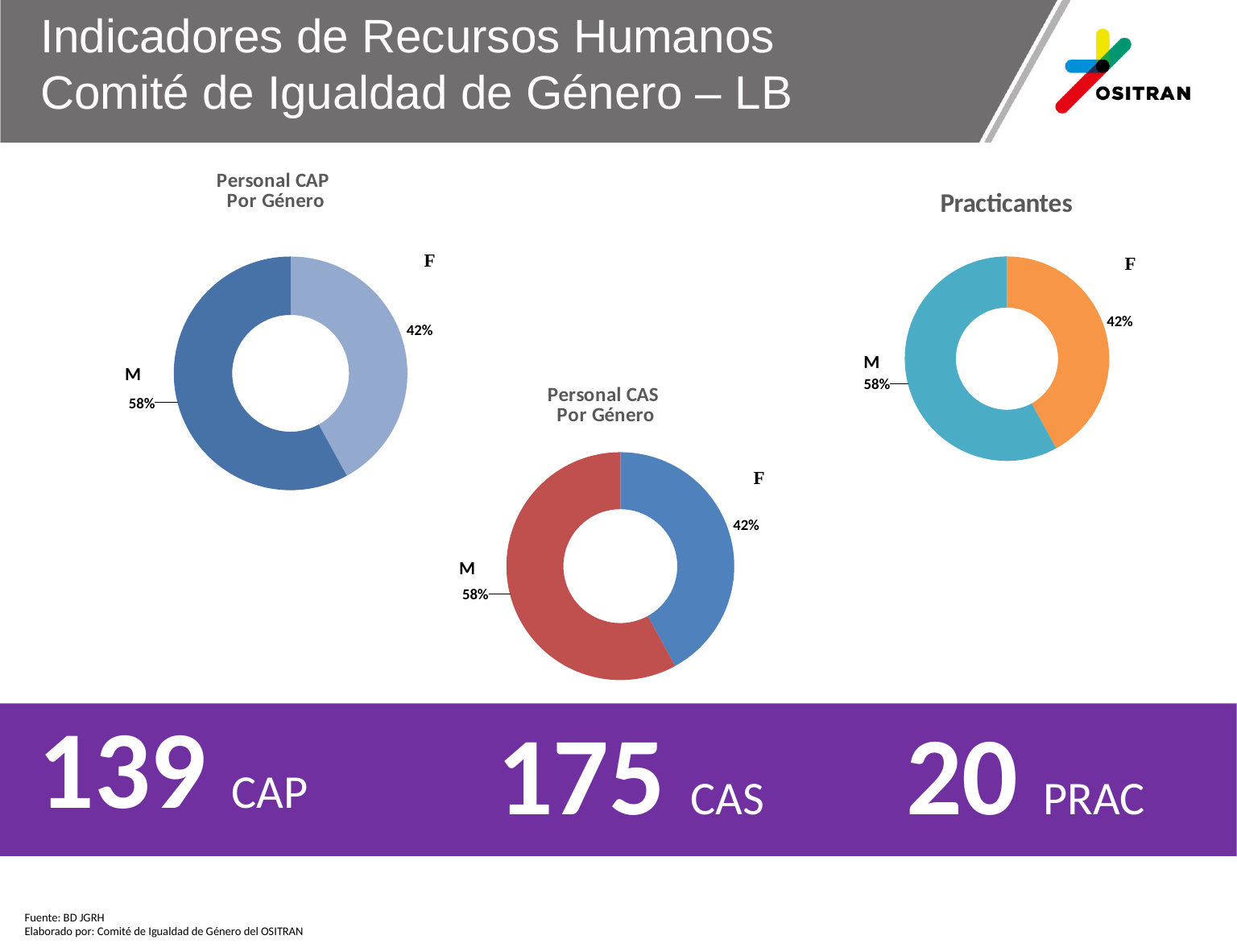
In the 'Personal CAS Por Género' chart, which category has the smallest share? F In the 'Personal CAS Por Género' chart, what share is labelled for F? 42% In the 'Personal CAP Por Género' chart, which category has the largest share? M What kind of chart is the 'Practicantes' chart? Doughnut chart How many doughnut charts are shown on the slide? 3 In the 'Personal CAP Por Género' chart, what is the difference in percentage points between M and F? 16 In the 'Practicantes' chart, what share is labelled for F? 42% How many categories does the 'Personal CAS Por Género' chart show? 2 In the 'Personal CAP Por Género' chart, what share is labelled for F? 42% In the 'Practicantes' chart, which category has the larger share, M or F? M In the 'Personal CAS Por Género' chart, what share is labelled for M? 58% In the 'Personal CAP Por Género' chart, what share is labelled for M? 58%